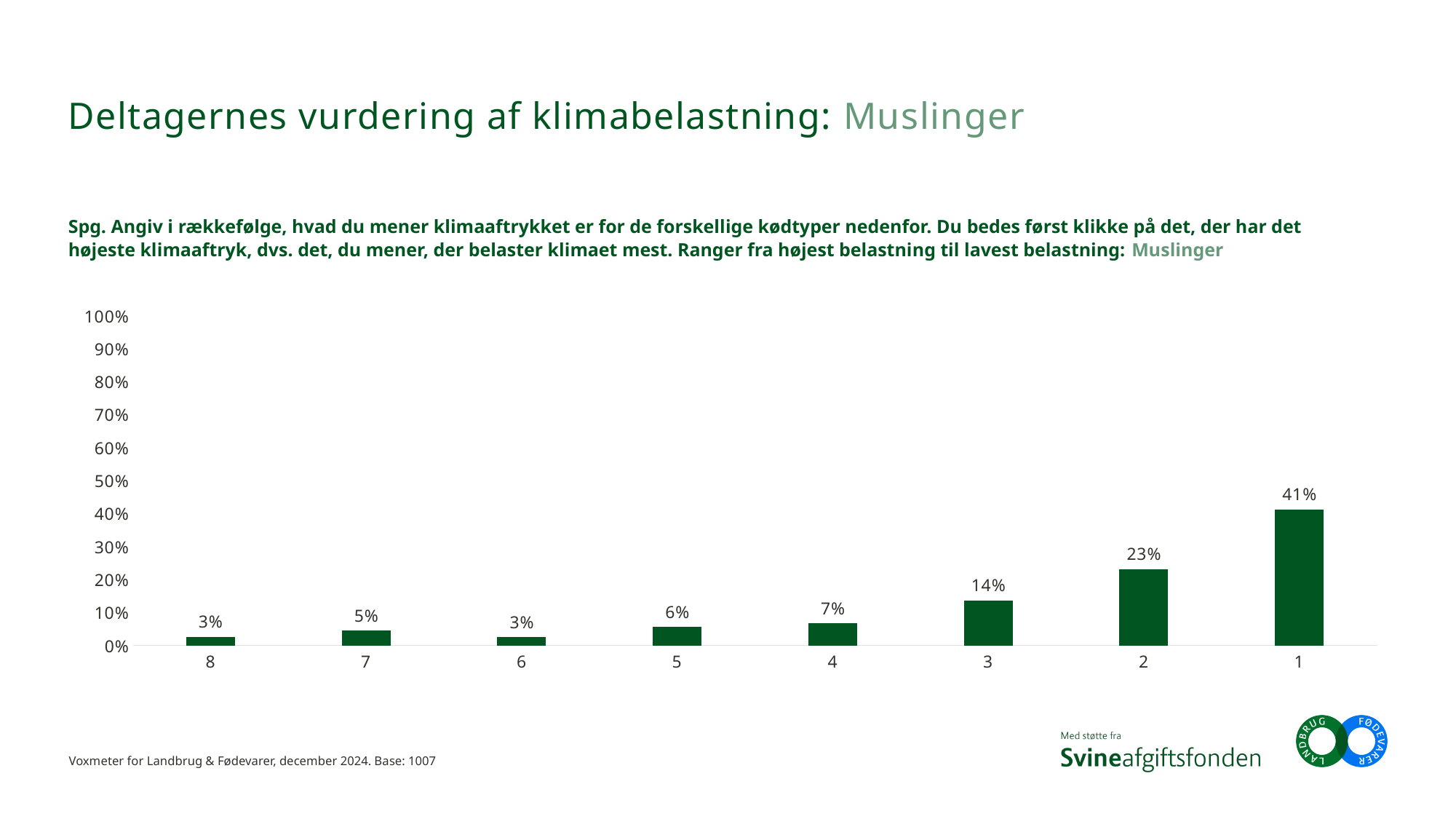
What is the value for rank 7? 5% What is the base (number of respondents) stated on the slide? 1007 Do the values generally rise or fall moving from rank 8 to rank 1 along the x axis? rise Which rank has the highest value? 1 Is the value for rank 2 greater or less than 20%? greater What is the difference between the values for rank 1 and rank 2? 18% How many categories are shown on the x axis? 8 What kind of chart is shown on the slide? bar chart Which is larger, the value for rank 4 or the value for rank 5? rank 4 What is the highest value shown on the y axis? 100% What is the value for rank 3? 14% What is the value for rank 1? 41%